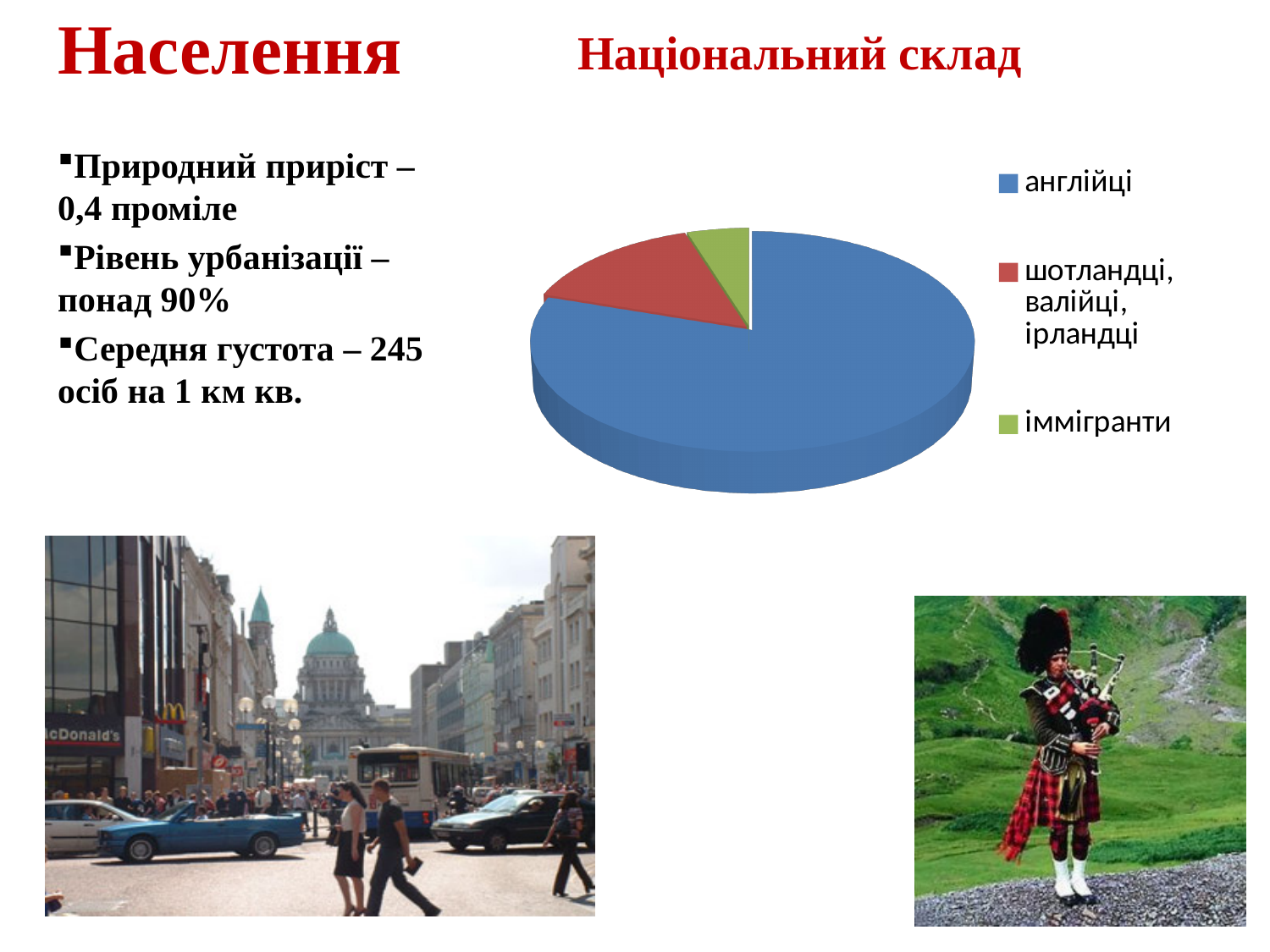
What colour is the slice for іммігранти? green Which slice is larger: англійці or іммігранти? англійці How many entries does the chart legend list? 3 What kind of chart is shown on the slide? pie chart Which slice is larger: шотландці, валійці, ірландці or іммігранти? шотландці, валійці, ірландці How many slices does the pie chart have? 3 Which category has the largest slice of the pie? англійці Which slice is larger: англійці or шотландці, валійці, ірландці? англійці Which category has the smallest slice of the pie? іммігранти What is the title of the chart? Національний склад